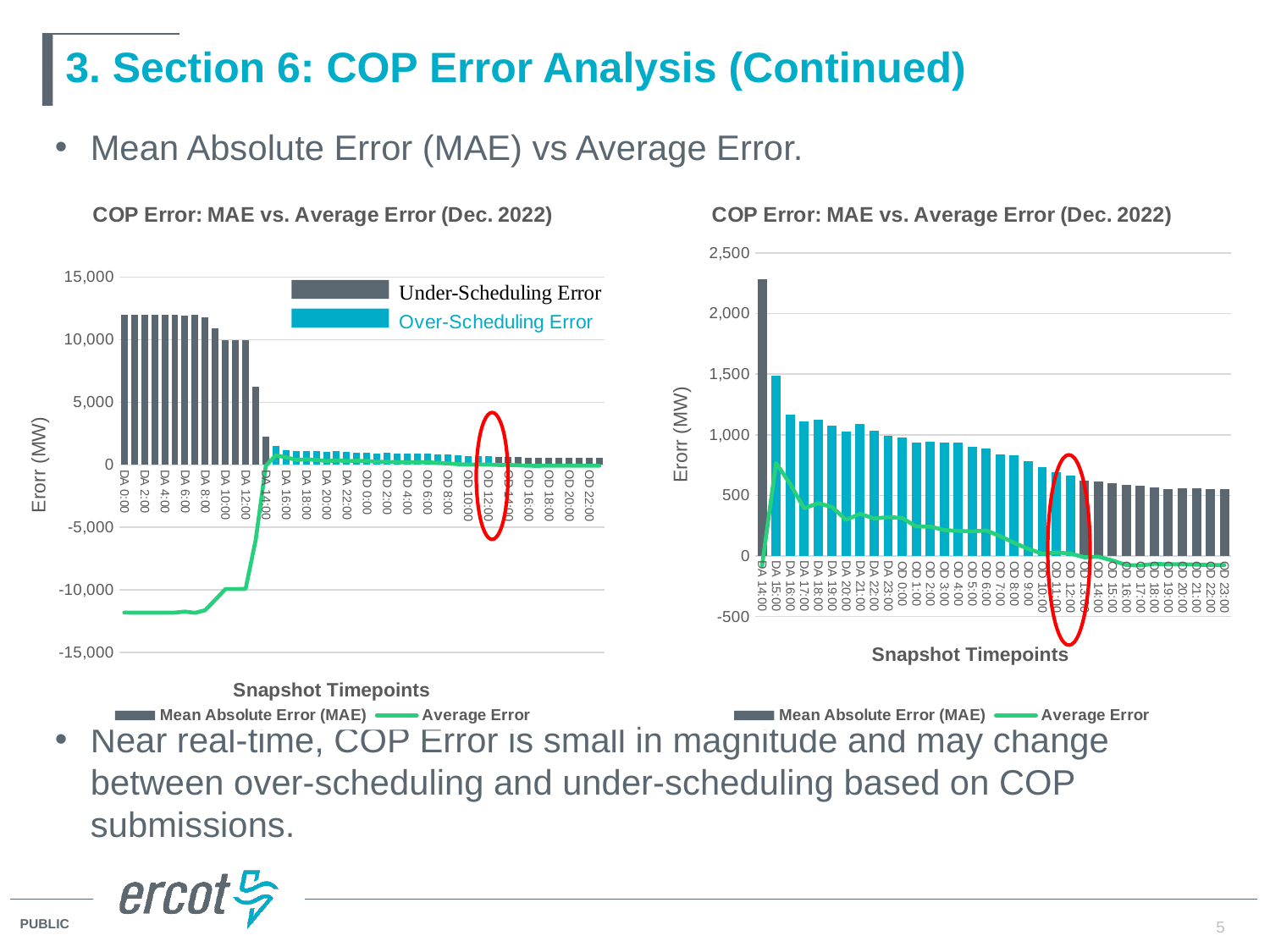
How many series does the legend of the right chart list? 2 In the right chart, is the Mean Absolute Error (MAE) at DA 14:00 greater or less than 2,000? greater In the left chart, is the Mean Absolute Error (MAE) at DA 0:00 greater or less than 10,000? greater What is the x-axis label of the right chart? Snapshot Timepoints In the right chart, which snapshot timepoint has the highest Average Error? DA 15:00 In the right chart, is the Mean Absolute Error (MAE) at OD 23:00 greater or less than 500? greater In the right chart, does the Mean Absolute Error (MAE) generally rise or fall from DA 14:00 to OD 23:00? fall What is the title of the left chart? COP Error: MAE vs. Average Error (Dec. 2022) In the right chart, which snapshot timepoint has the highest Mean Absolute Error (MAE)? DA 14:00 What kind of chart is the left chart on the slide? bar chart with a line